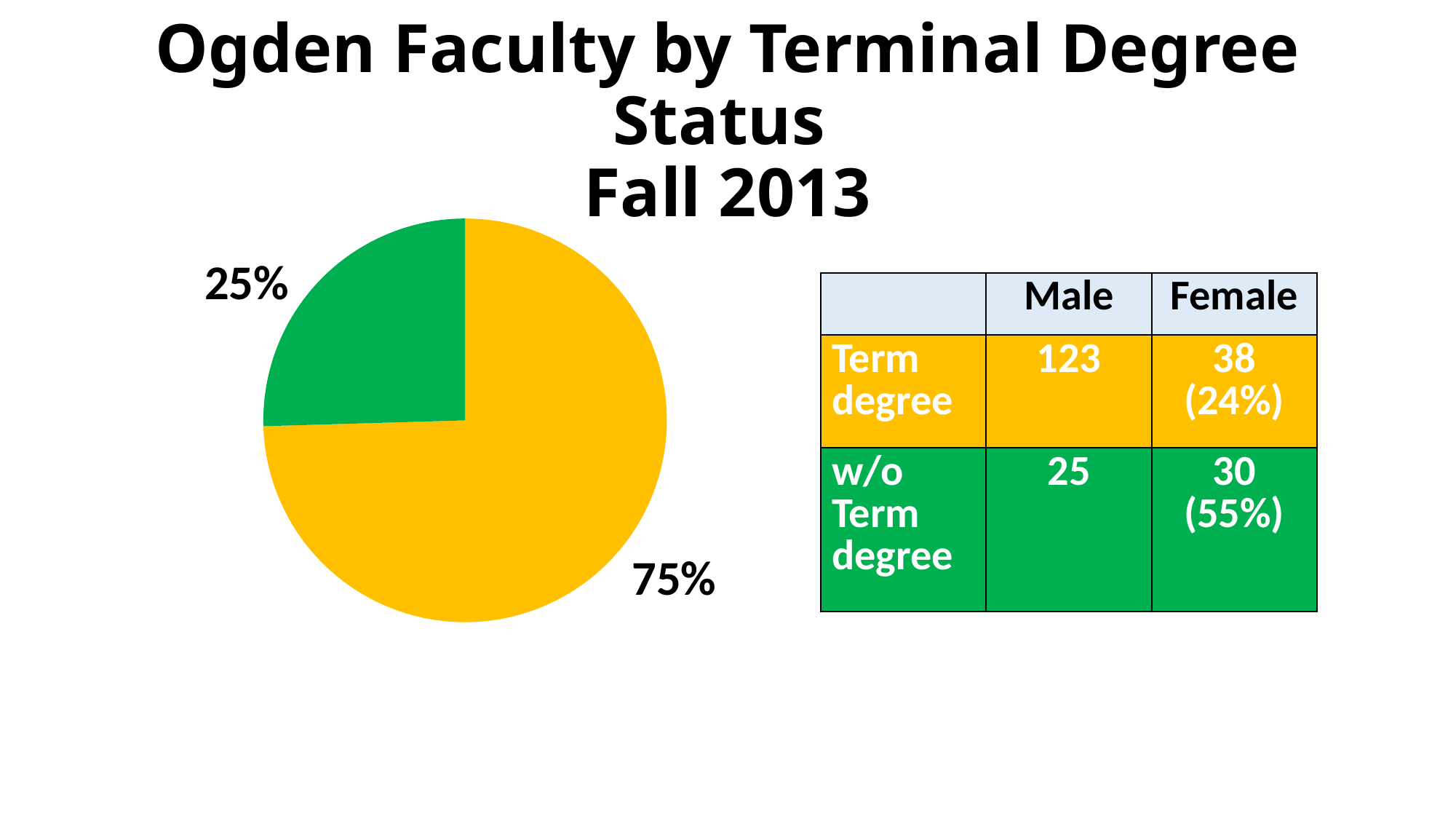
Is the yellow slice or the green slice of the pie chart larger? the yellow slice What is the difference in percentage points between the two slices of the pie chart? 50 How many slices does the pie chart have? 2 Which slice of the pie chart is the largest? the yellow slice (75%) Which colour is used for the larger slice of the pie chart? yellow Which slice of the pie chart is the smallest? the green slice (25%) What percentage is shown for the yellow slice of the pie chart? 75% What percentage is shown for the green slice of the pie chart? 25% What is the title of the slide containing the pie chart? Ogden Faculty by Terminal Degree Status Fall 2013 What share of the pie does the green slice represent? 25% What kind of chart is shown on the slide? pie chart